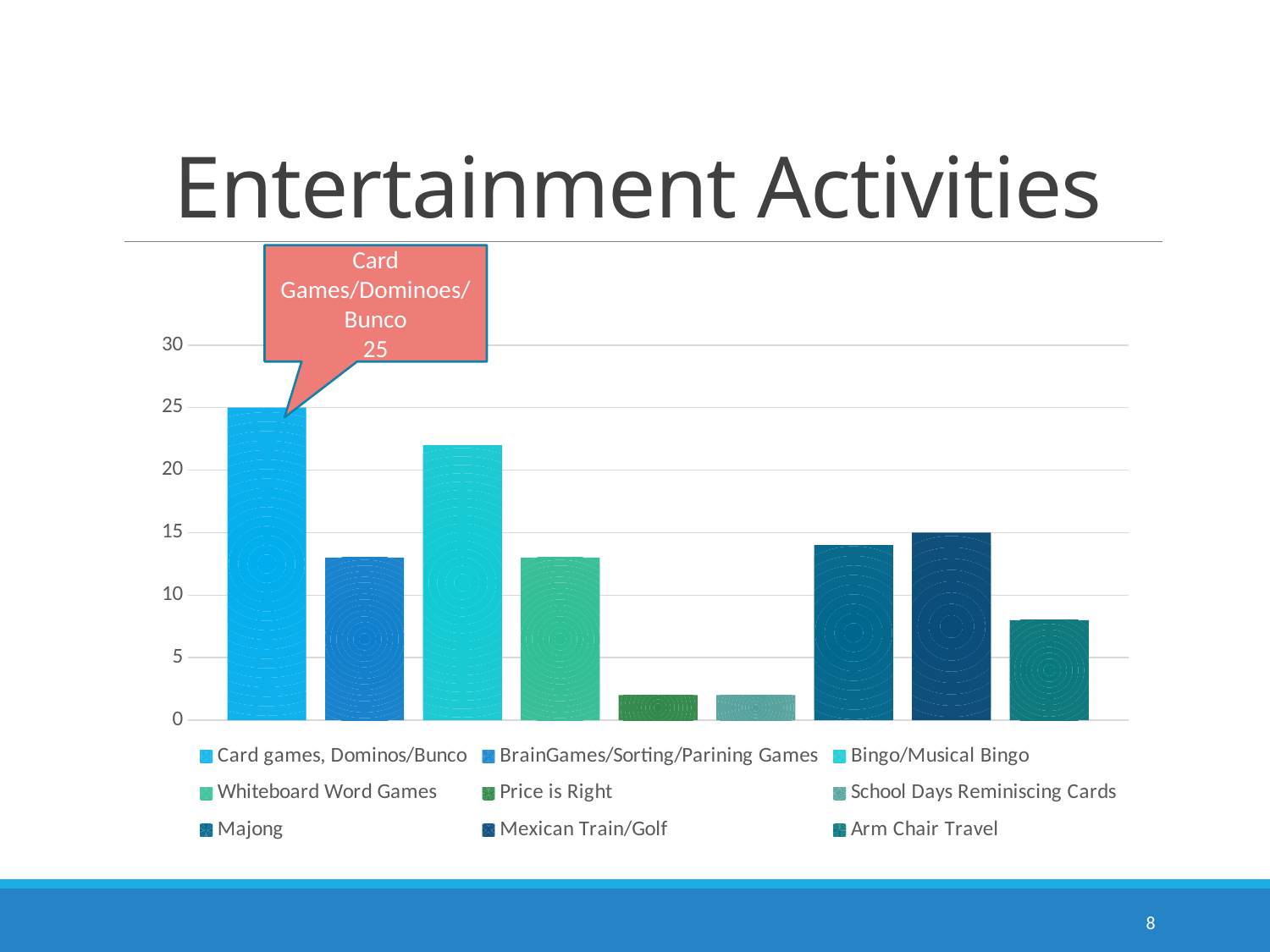
Is the value for Arm Chair Travel greater or less than 10? less Is the value for Price is Right greater or less than 5? less What is the title of the slide containing the chart? Entertainment Activities Is the value for Mexican Train/Golf greater or less than 10? greater What kind of chart is shown on the slide? bar chart Which is larger, the value for Majong or the value for Arm Chair Travel? Majong Which activity has the highest bar? Card games, Dominos/Bunco What is the value shown for Card Games/Dominoes/Bunco? 25 How many entries does the legend list? 9 Which is larger, the value for Bingo/Musical Bingo or the value for BrainGames/Sorting/Parining Games? Bingo/Musical Bingo How many bars are plotted in the chart? 9